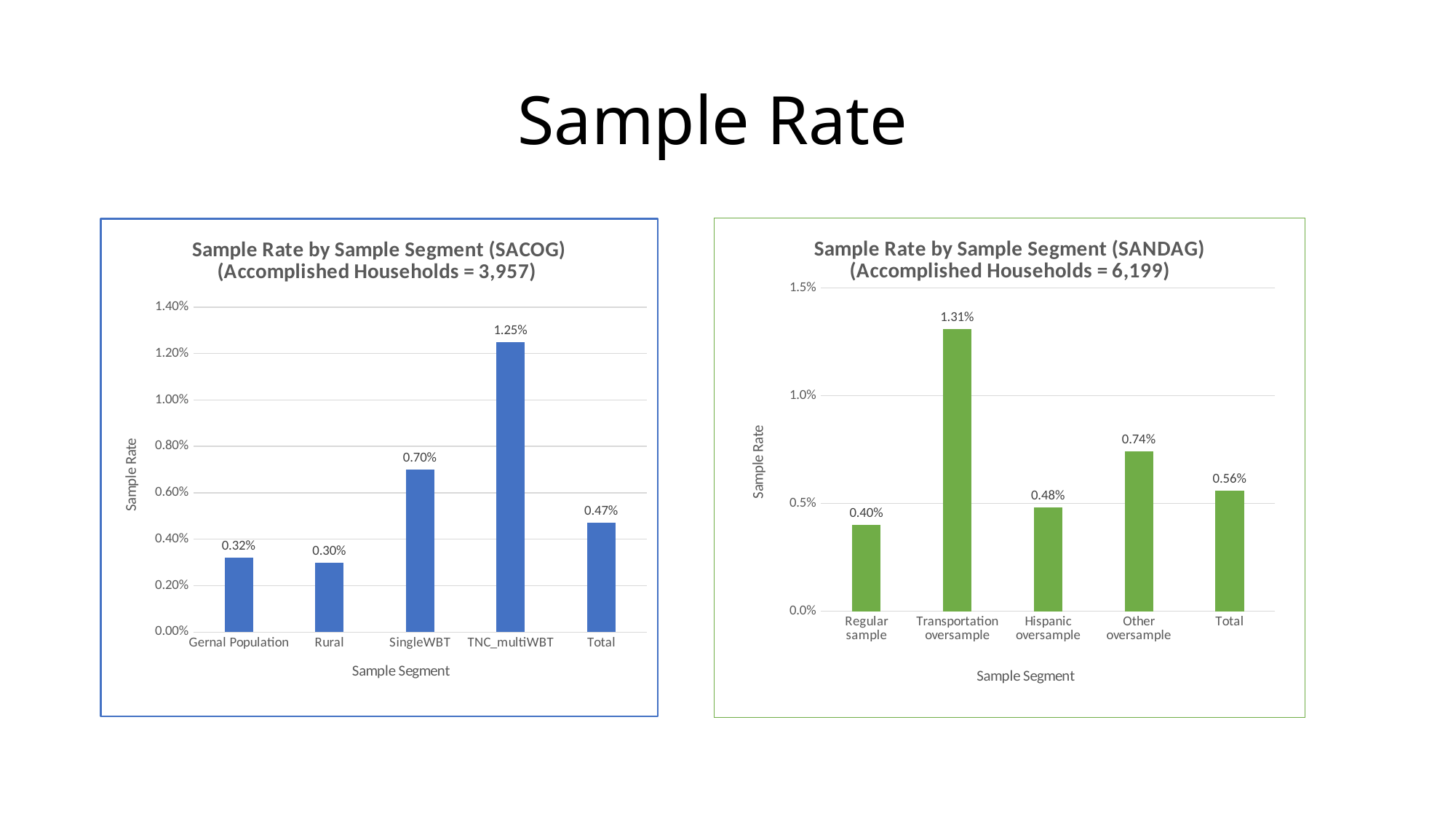
In the SACOG chart, which has a higher sample rate, Gernal Population or Total? Total In the SACOG chart, what is the difference between the sample rates for TNC_multiWBT and Rural? 0.95% In the SACOG chart, which sample segment has the highest sample rate? TNC_multiWBT What colour are the bars in the SACOG chart? Blue In the SANDAG chart, what is the difference between the sample rates for Other oversample and Regular sample? 0.34% In the SACOG chart, what is the sample rate for SingleWBT? 0.70% In the SANDAG chart, is the value for Transportation oversample greater or less than 1.0%? greater In the SANDAG chart, what is the sample rate for the Hispanic oversample segment? 0.48% In the SANDAG chart, which sample segment has the lowest sample rate? Regular sample How many sample segments are shown in the SACOG chart? 5 What kind of chart is the SANDAG chart? Bar chart According to the SANDAG chart title, how many accomplished households were there? 6,199